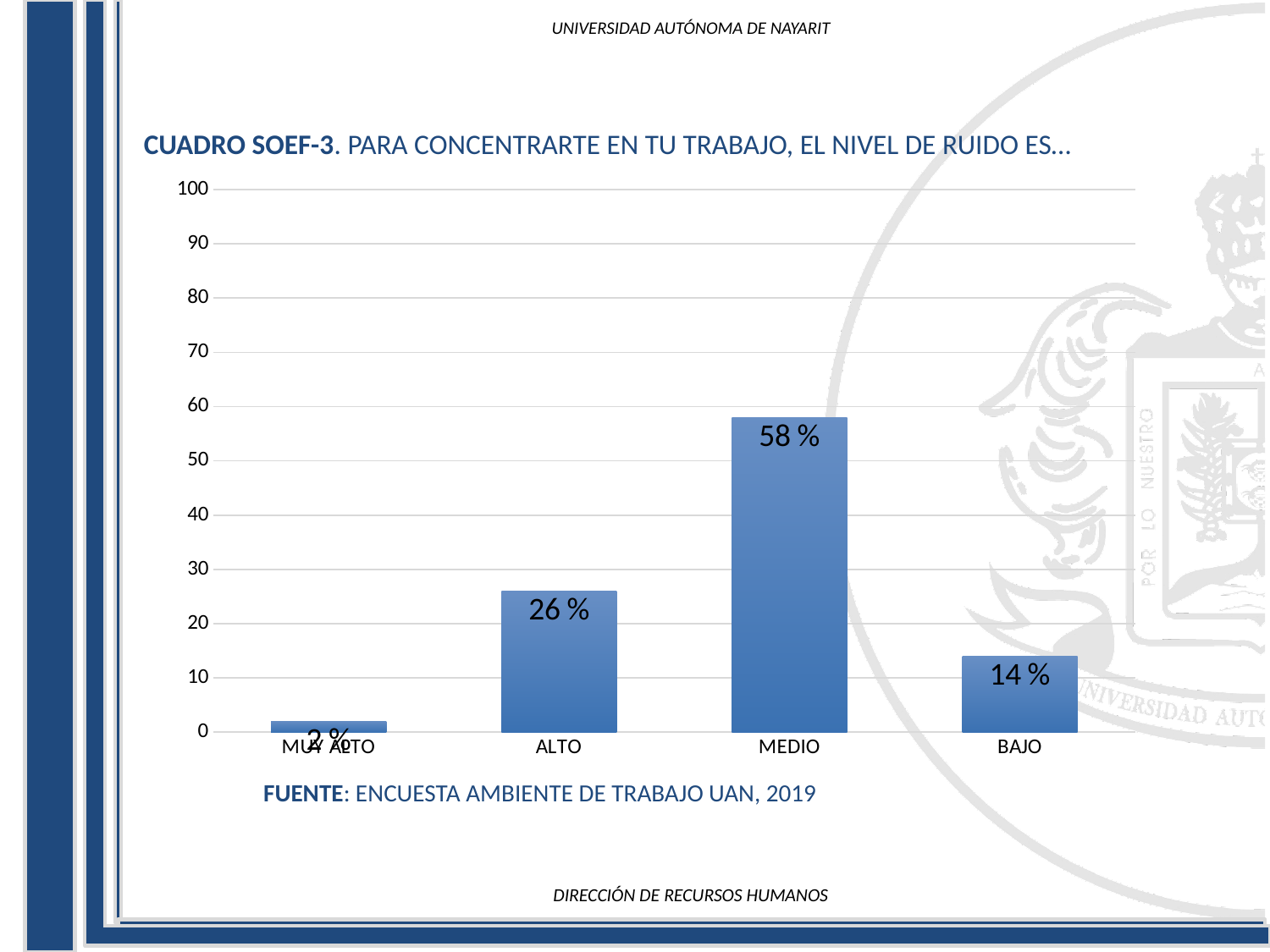
What kind of chart is shown on the slide? bar chart What is the difference between the values for ALTO and BAJO? 12 % What is the value for BAJO? 14 % What is the difference between the values for MEDIO and ALTO? 32 % Which is larger, the value for ALTO or the value for BAJO? ALTO Is the value for MEDIO greater or less than 50? greater Which category has the lowest value? MUY ALTO What is the value for ALTO? 26 % What is the value for MEDIO? 58 % How many categories are shown on the x axis? 4 Which category has the highest value? MEDIO What source is cited below the chart? ENCUESTA AMBIENTE DE TRABAJO UAN, 2019